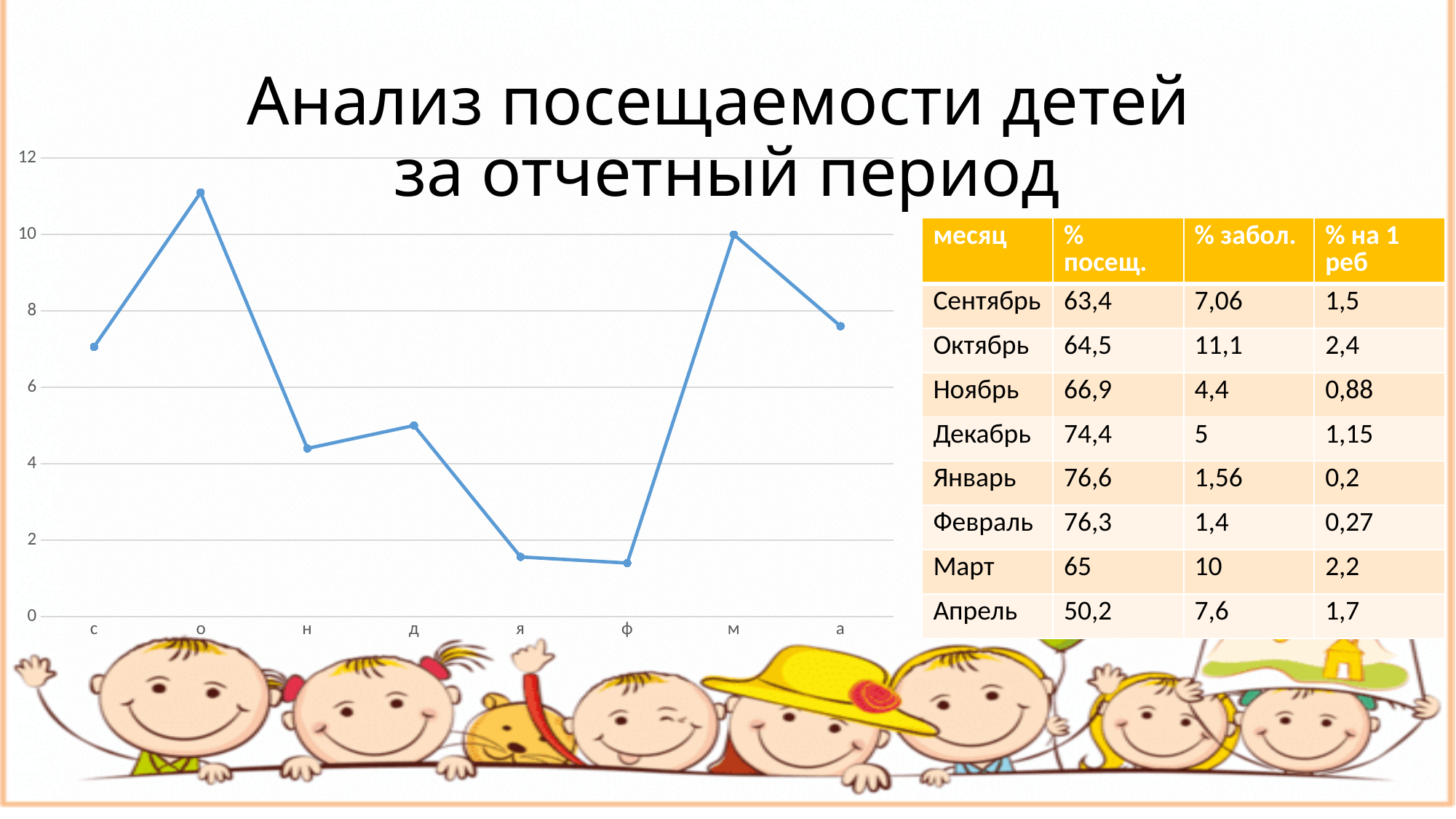
Is the value for с on the line chart greater or less than 8? less What kind of chart is shown on the slide? line chart Which category on the x axis has the highest value on the line chart? о How many data points are plotted on the line chart? 8 Is the value for я on the line chart greater or less than 2? less Is the value for а on the line chart greater or less than 6? greater On the line chart, does the value rise or fall from о to н? fall On the line chart, which has the larger value, н or м? м On the line chart, does the value rise or fall from с to о? rise